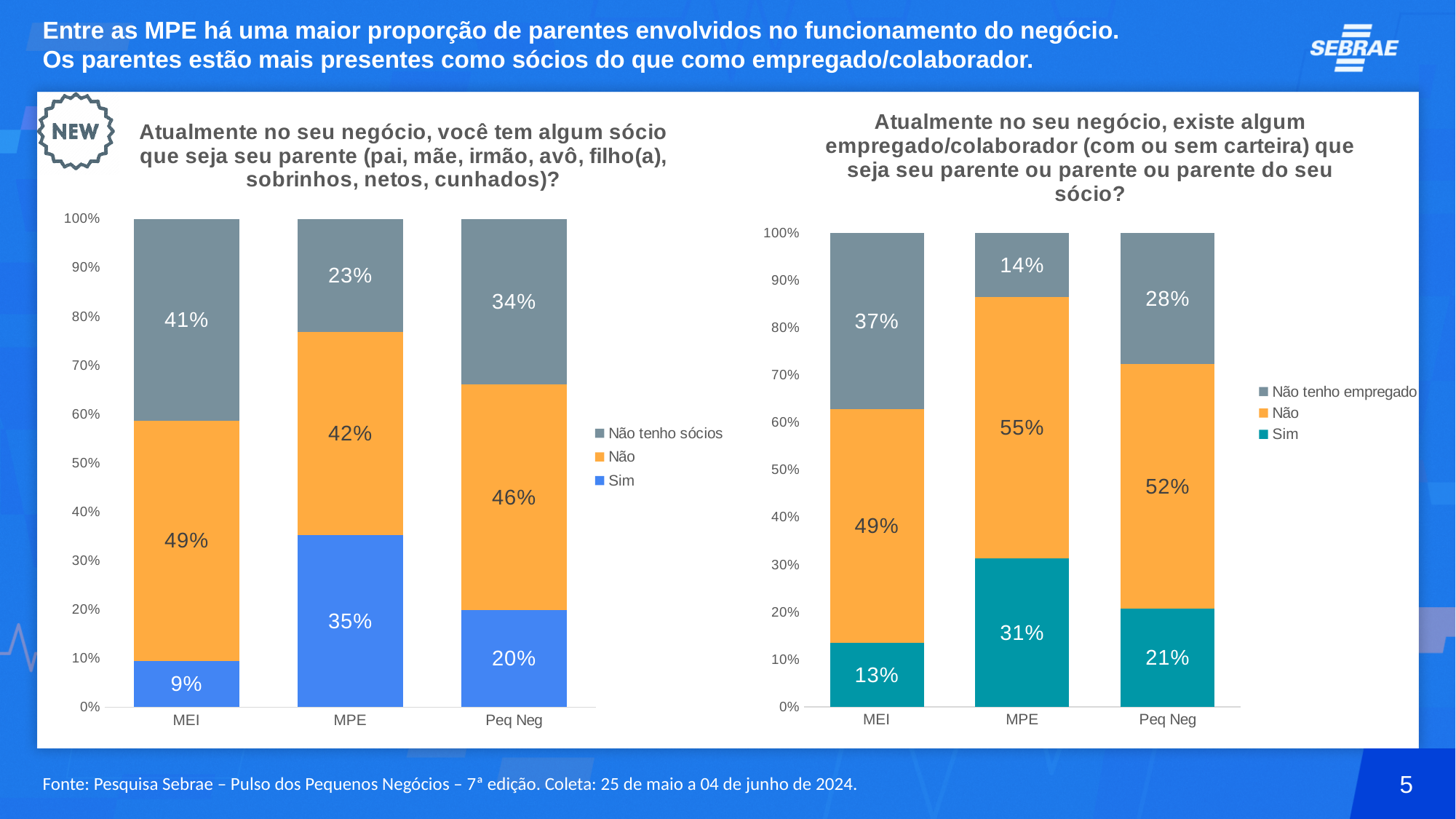
In the left chart (about sócios), what is the difference between the 'Não' values for MEI and MPE? 7 percentage points In the right chart (about empregado/colaborador), what is the 'Não tenho empregado' value for MEI? 37% In the left chart (about sócios), how many categories are shown on the x axis? 3 In the right chart (about empregado/colaborador), how many series does the legend list? 3 In the left chart (about sócios), what is the 'Sim' value for MPE? 35% In the right chart (about empregado/colaborador), which is larger: the 'Não' value for MPE or for Peq Neg? MPE In the left chart (about sócios), what is the 'Não tenho sócios' value for Peq Neg? 34% In the right chart (about empregado/colaborador), what colour represents the 'Sim' series? Teal In the left chart (about sócios), which category has the highest 'Sim' value? MPE In the right chart (about empregado/colaborador), which category has the lowest 'Sim' value? MEI What kind of chart is the left chart (about sócios)? Stacked bar chart In the right chart (about empregado/colaborador), what is the 'Não tenho empregado' value for MPE? 14%